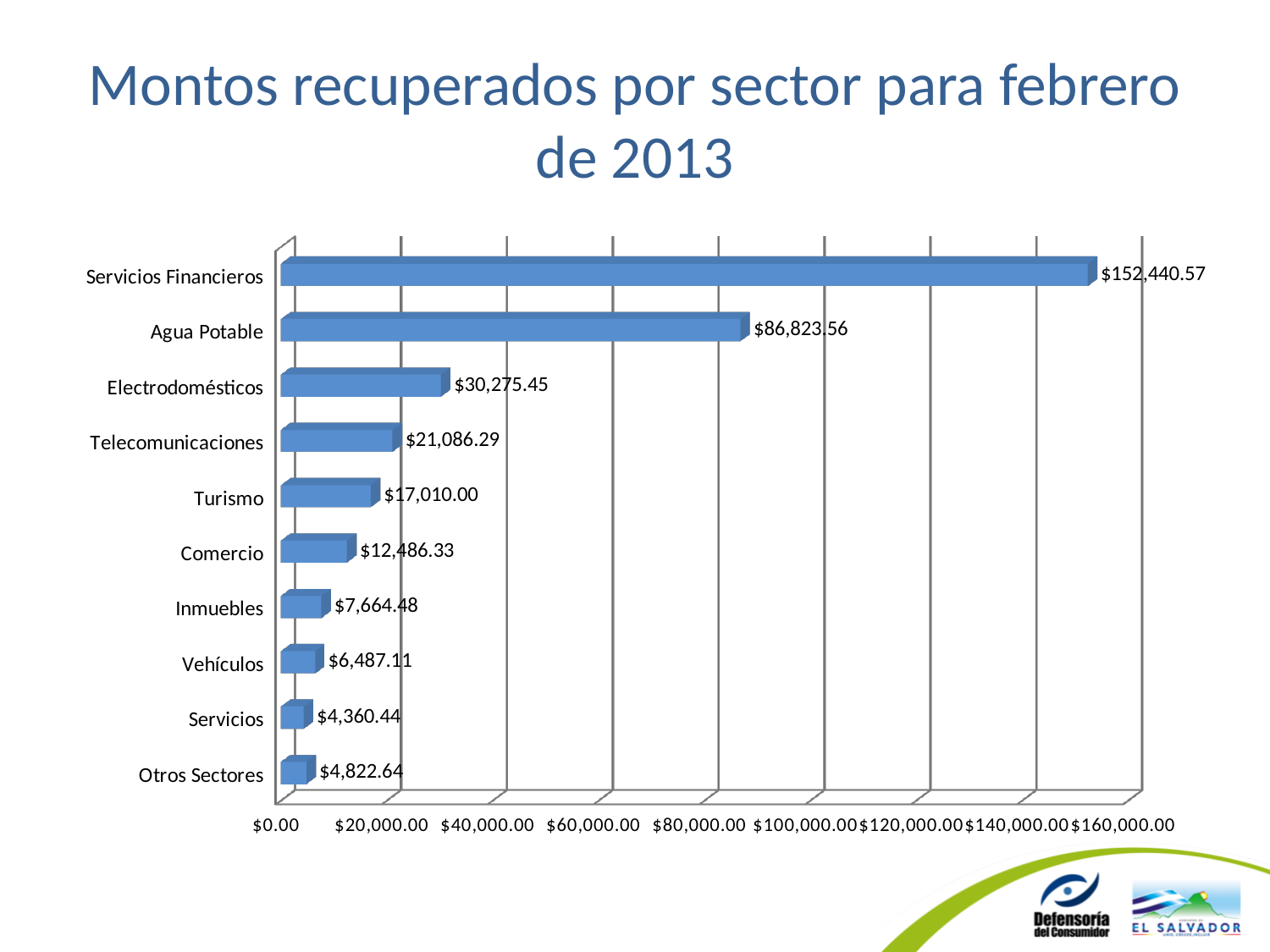
What is the value for Vehículos? $6,487.11 What is the value for Agua Potable? $86,823.56 What is the value for Turismo? $17,010.00 How many sectors are shown in the chart? 10 What is the difference between the values for Servicios Financieros and Agua Potable? $65,617.01 What is the difference between the values for Electrodomésticos and Telecomunicaciones? $9,189.16 Which sector has the lowest recovered amount? Servicios Is the value for Agua Potable greater or less than $80,000.00? greater Which sector has the highest recovered amount? Servicios Financieros What kind of chart is shown on the slide? Bar chart Which is larger, the value for Comercio or the value for Inmuebles? Comercio What is the value for Servicios Financieros? $152,440.57